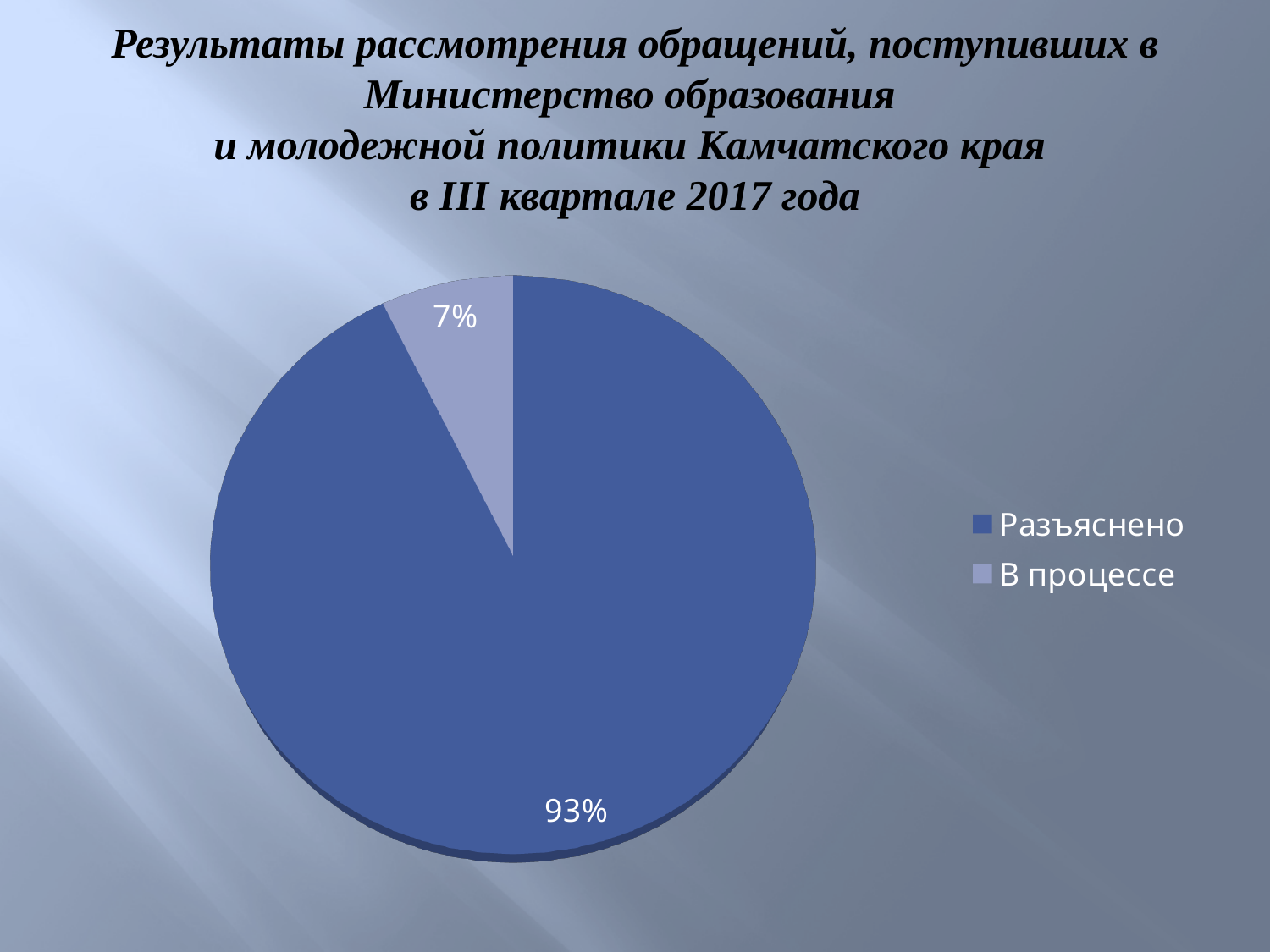
What kind of chart is shown on the slide? Pie chart What is the difference in percentage points between the "Разъяснено" and "В процессе" slices? 86 What share of the pie does "Разъяснено" take? 93% Which quarter and year does the slide title refer to? III квартал 2017 года Which category has the smallest slice of the pie? В процессе What colour is the "В процессе" slice? Light purple-blue Which category has the largest slice of the pie? Разъяснено How many entries does the legend list? 2 How many slices does the pie chart have? 2 Which is larger: the "Разъяснено" slice or the "В процессе" slice? Разъяснено What share of the pie does "В процессе" take? 7%